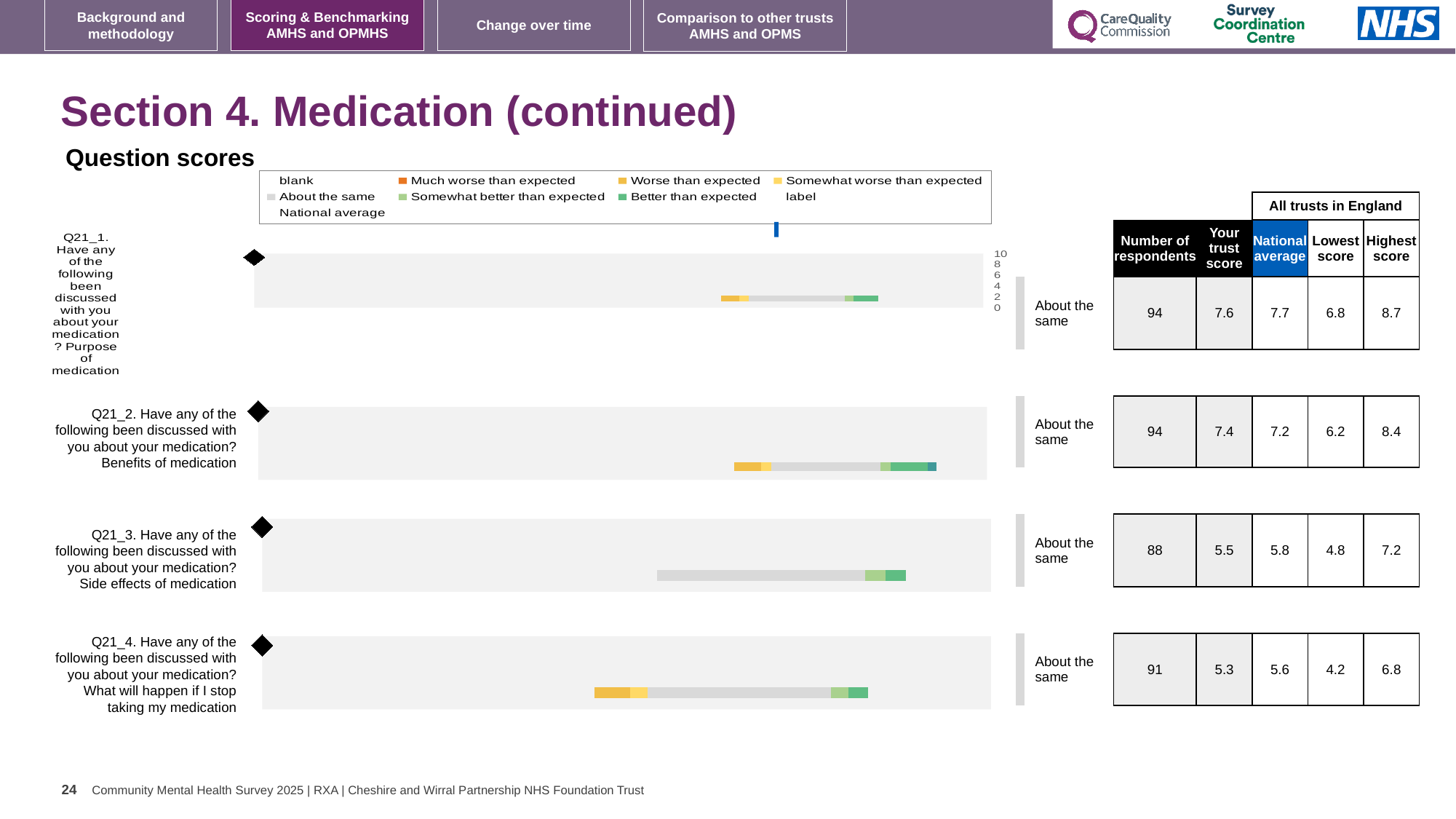
Which question has the lowest 'Your trust score' on the slide? Q21_4 (5.3) What kind of chart is used to show the benchmark for Q21_2 (Benefits of medication)? bar chart In the legend, which category is shown in grey? About the same For the Q21_2 chart, which is larger: the trust score or the national average? the trust score (7.4) What benchmark category is shown next to the Q21_3 chart? About the same For the Q21_2 chart, what is the difference between the highest score and the lowest score across all trusts in England? 2.2 For the Q21_1 chart (Purpose of medication), what is the 'Your trust score' shown in the table? 7.6 In the legend, what colour represents 'Better than expected'? green Which question has the highest 'Your trust score' on the slide? Q21_1 (7.6) For the Q21_4 chart (What will happen if I stop taking my medication), how many respondents are shown? 91 For the Q21_3 chart (Side effects of medication), what is the national average shown? 5.8 How many question charts are shown on the slide? 4